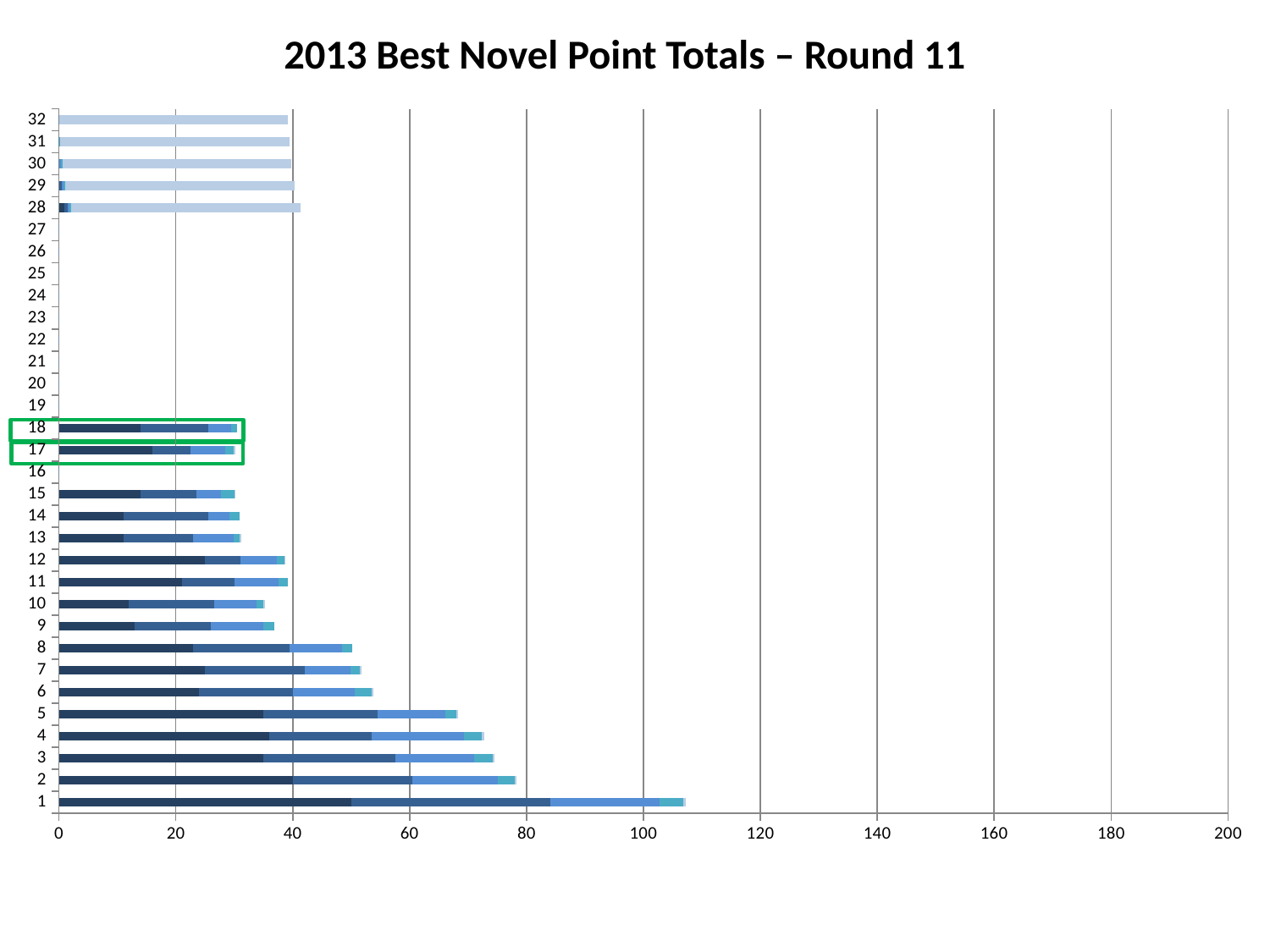
Is the total value for category 3 greater or less than 80? less Is the total value for category 2 greater or less than 80? less Which has the longer bar, category 1 or category 2? 1 What kind of chart is shown on the slide? bar chart Which category has the longest bar in the chart? 1 What is the title of the chart? 2013 Best Novel Point Totals – Round 11 Which has the longer bar, category 5 or category 10? 5 How many categories are listed on the vertical axis of the chart? 32 Is the total value for category 1 greater or less than 100? greater Which two categories are highlighted with green boxes on the chart? 18 and 17